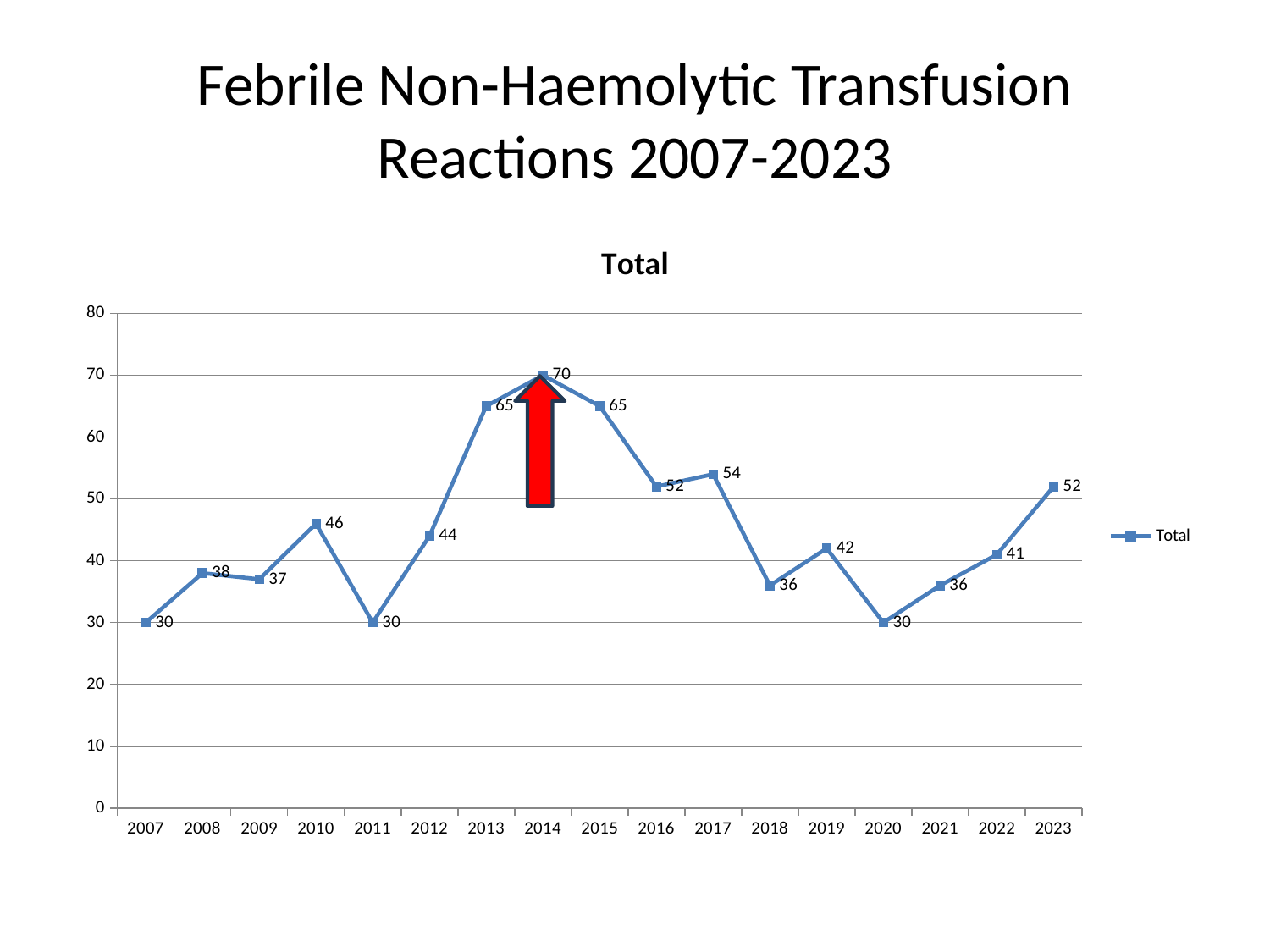
What is the difference between the values for 2017 and 2018? 18 What kind of chart is shown? line chart What is the difference between the values for 2014 and 2015? 5 What is the value for 2010? 46 Do the values rise or fall from 2011 to 2014? rise How many series does the legend list? 1 How many years are plotted on the x axis? 17 Is the value for 2016 greater or less than 50? greater Which is larger, the value for 2012 or the value for 2013? 2013 Which year has the highest value? 2014 What is the value for 2023? 52 What is the value for 2014? 70